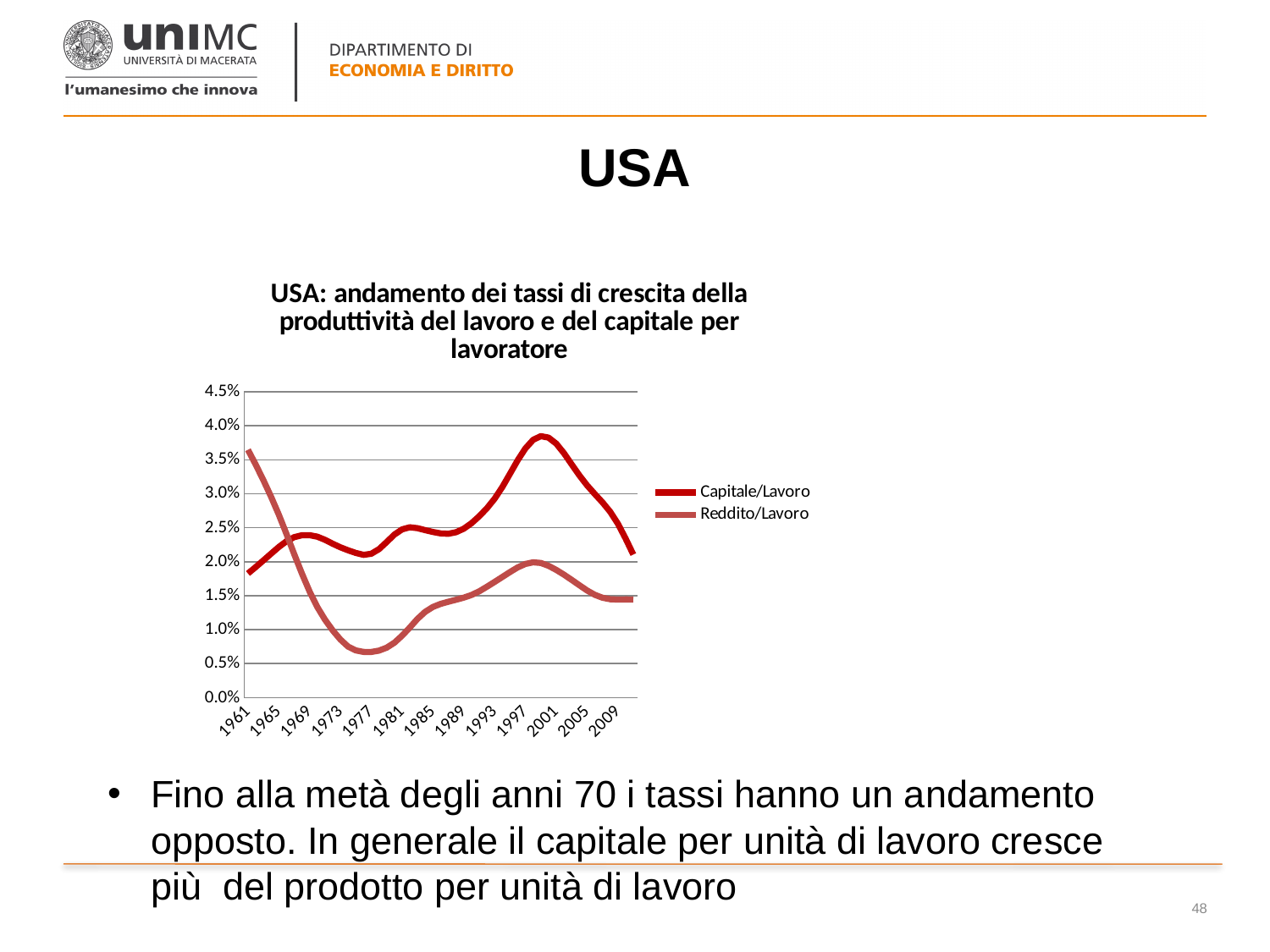
How many series does the legend list? 2 What kind of chart is shown on the slide? line chart Does the Reddito/Lavoro series rise or fall between 1961 and 1977? fall Is the value for Capitale/Lavoro in 2001 greater or less than 3.5%? greater Is the value for Capitale/Lavoro in 1961 greater or less than 2.0%? less What is the title of the chart? USA: andamento dei tassi di crescita della produttività del lavoro e del capitale per lavoratore In 1961, which series has the higher value, Capitale/Lavoro or Reddito/Lavoro? Reddito/Lavoro In 2001, which series has the higher value, Capitale/Lavoro or Reddito/Lavoro? Capitale/Lavoro Is the value for Reddito/Lavoro in 1977 greater or less than 1.0%? less How many year labels are shown on the x axis? 13 What are the two series named in the legend? Capitale/Lavoro and Reddito/Lavoro